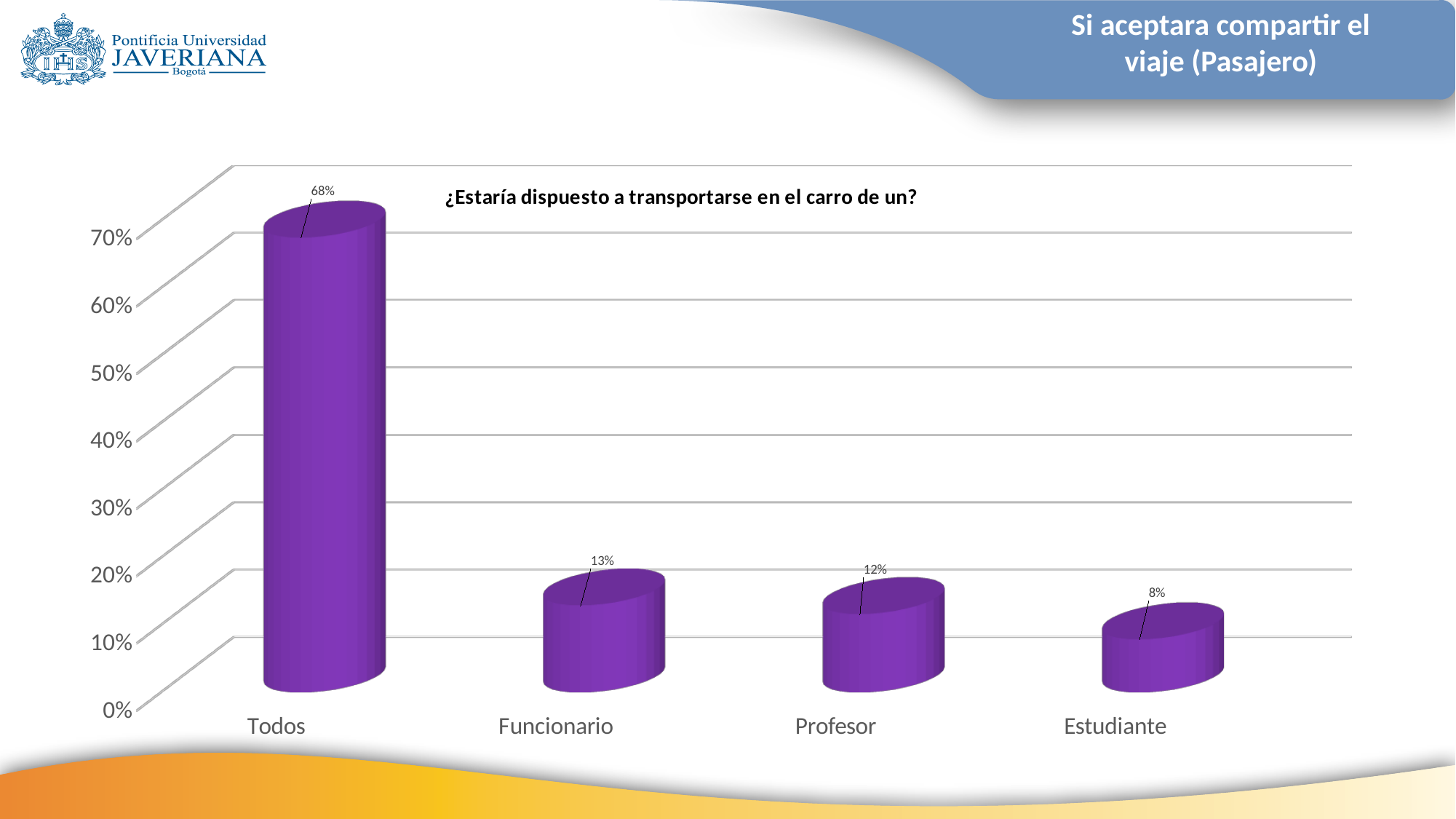
What is the value for Todos? 68% Is the value for Todos greater or less than 60%? greater What is the difference between the values for Todos and Funcionario? 55% Which is larger, the value for Funcionario or the value for Estudiante? Funcionario Which category has the lowest value? Estudiante What kind of chart is shown on the slide? bar chart How many categories are shown on the x axis? 4 What is the difference between the values for Profesor and Estudiante? 4% What is the value for Profesor? 12% Which category has the highest value? Todos What is the value for Estudiante? 8% What is the value for Funcionario? 13%